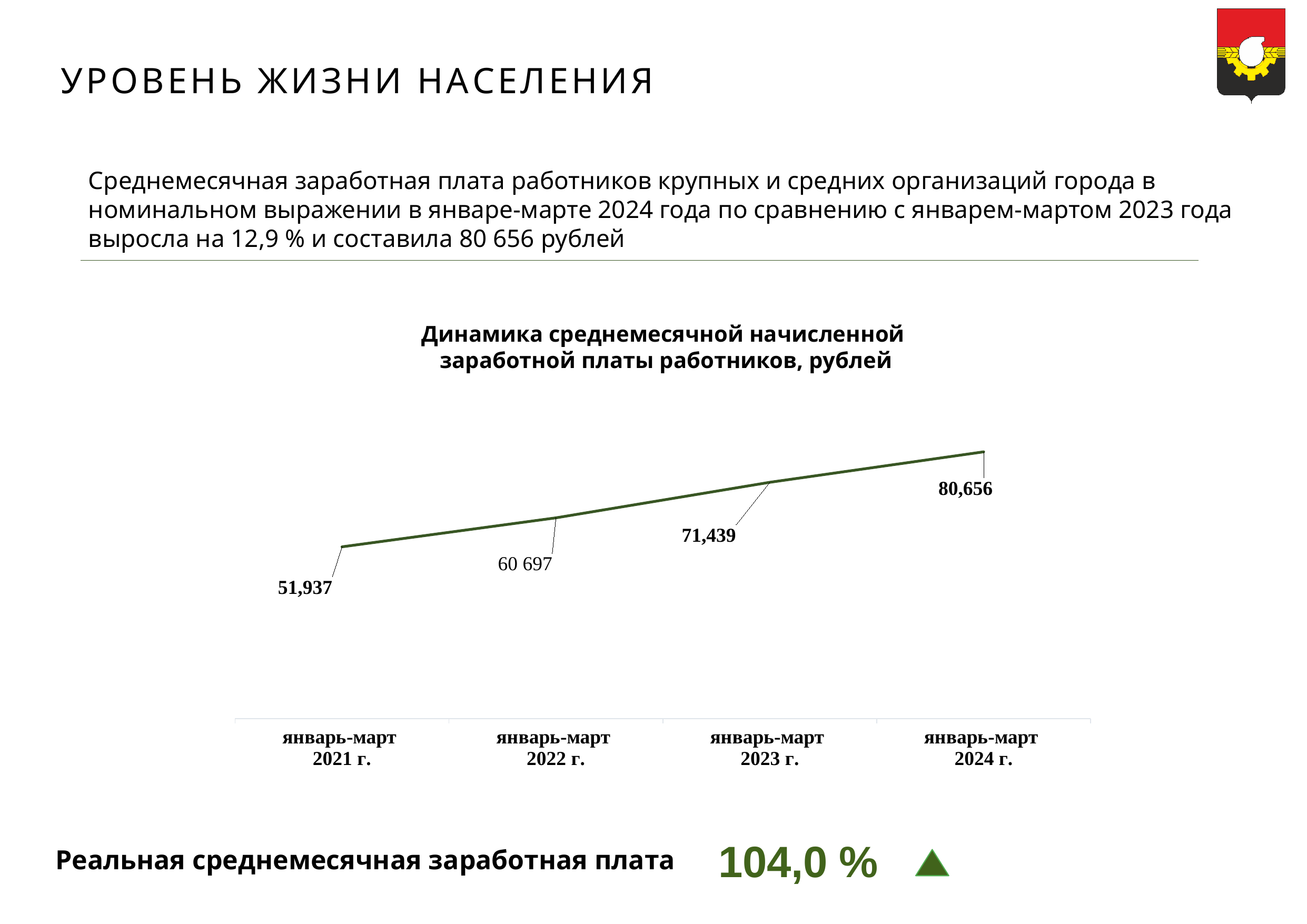
How many data points are plotted on the chart? 4 What is the difference between the values for январь-март 2024 г. and январь-март 2023 г.? 9,217 What is the value for январь-март 2021 г.? 51,937 Which is larger, the value for январь-март 2023 г. or январь-март 2022 г.? январь-март 2023 г. Do the values rise or fall from январь-март 2021 г. to январь-март 2024 г.? rise Which period has the highest value? январь-март 2024 г. What type of chart is shown on the slide? line chart Which period has the lowest value? январь-март 2021 г. What is the difference between the values for январь-март 2022 г. and январь-март 2021 г.? 8,760 What is the value for январь-март 2022 г.? 60 697 What is the value for январь-март 2024 г.? 80,656 What is the value for январь-март 2023 г.? 71,439